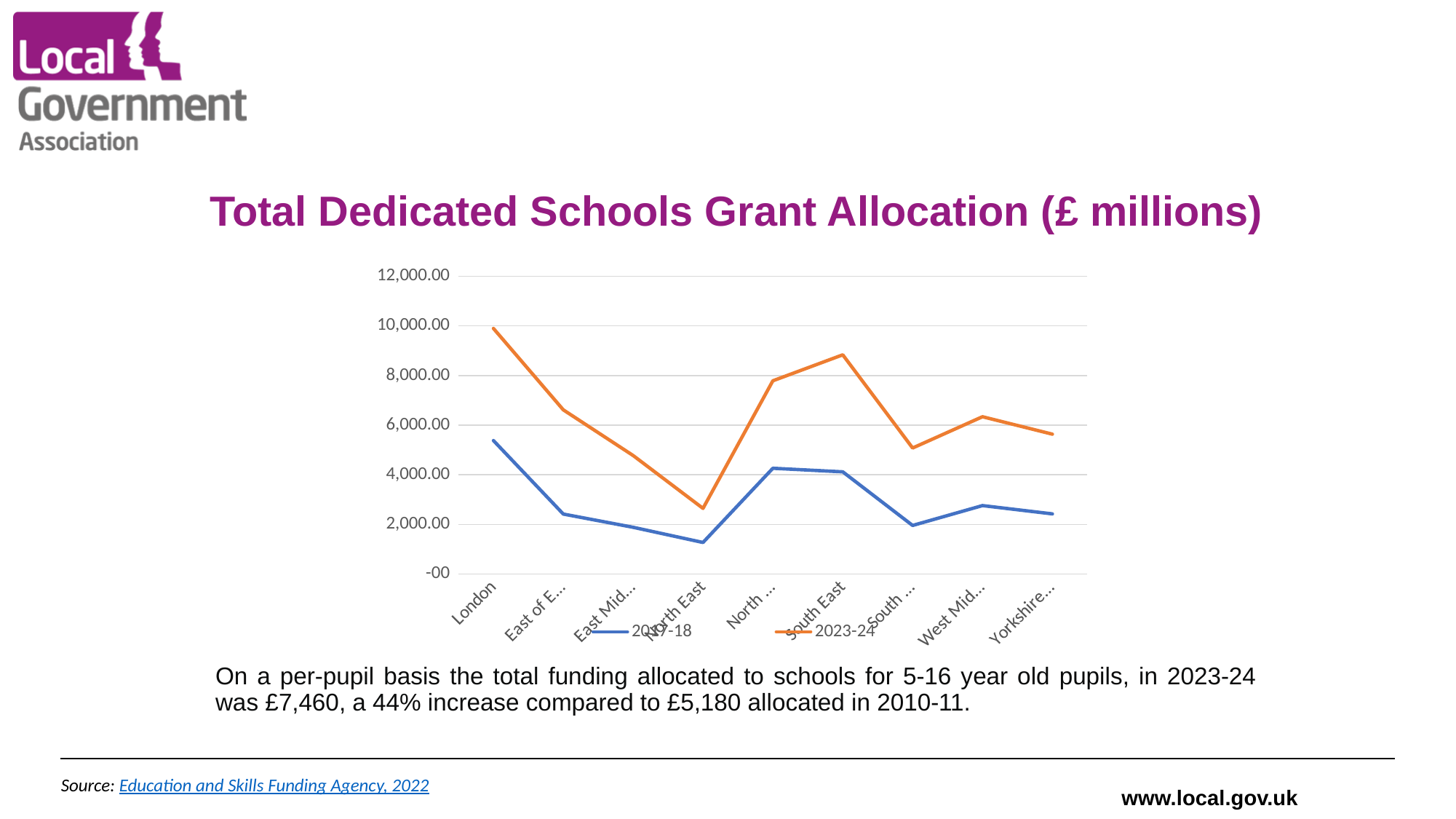
What kind of chart is shown on the slide? Line chart Is the 2023-24 value for North East greater or less than 4,000.00? less Which region has the lowest 2023-24 Dedicated Schools Grant allocation? North East Which region has the highest 2017-18 Dedicated Schools Grant allocation? London Which region has the lowest 2017-18 Dedicated Schools Grant allocation? North East Is the 2017-18 value for North East greater or less than 2,000.00? less How many regions are plotted along the x axis? 9 How many series does the legend list? 2 Is the 2023-24 value for London greater or less than 8,000.00? greater Which region has the highest 2023-24 Dedicated Schools Grant allocation? London What is the title of the chart? Total Dedicated Schools Grant Allocation (£ millions) For 2023-24, which is larger: the allocation for London or for South East? London